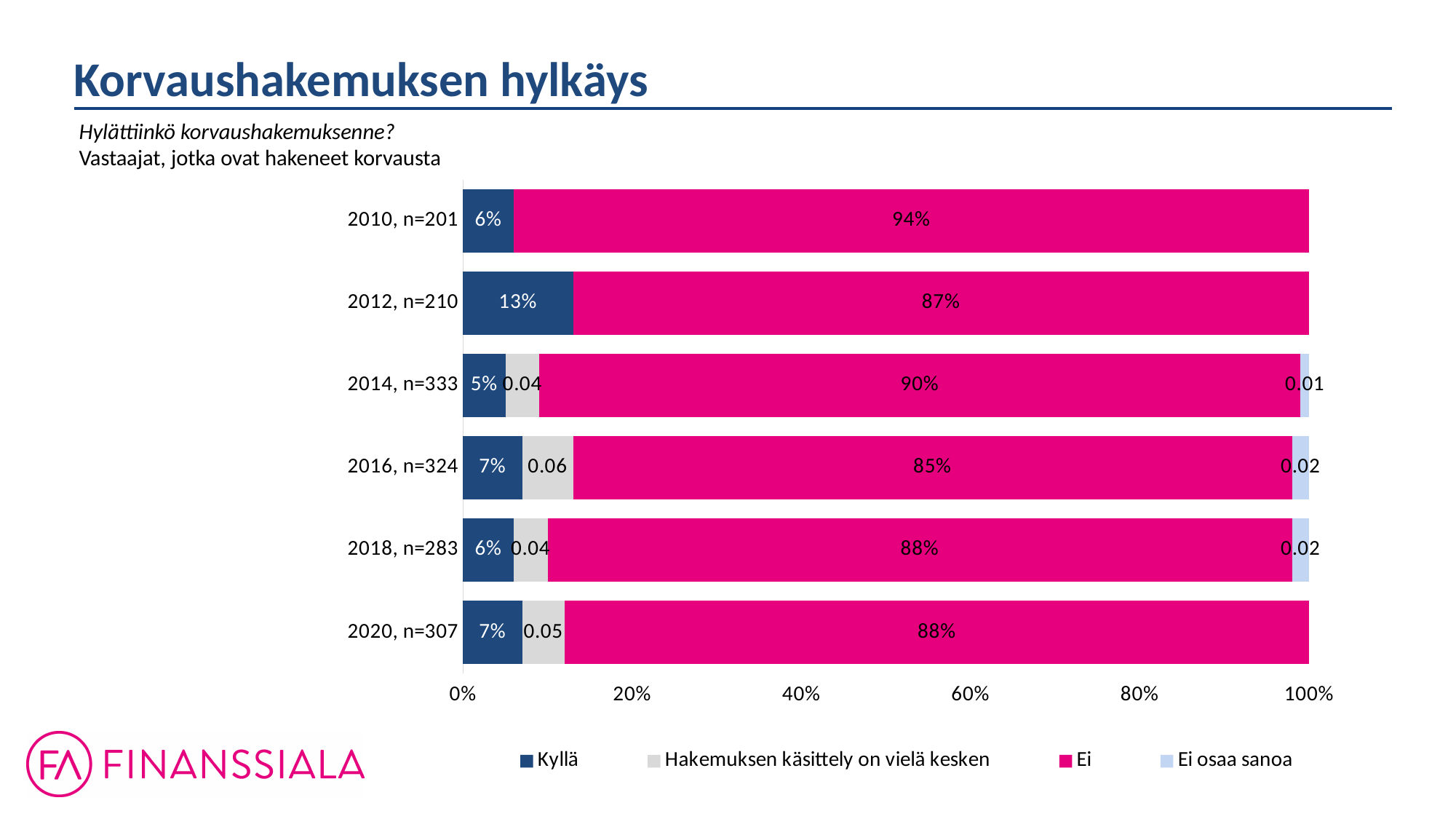
What is the value for Kyllä in 2012, n=210? 13% What kind of chart is shown on the slide? Stacked bar chart Which is larger: the Ei value in 2014, n=333 or in 2018, n=283? 2014, n=333 What is the value for Hakemuksen käsittely on vielä kesken in 2016, n=324? 0.06 What is the value for Ei in 2010, n=201? 94% How many series does the legend list? 4 What is the value for Ei osaa sanoa in 2014, n=333? 0.01 Which year has the lowest value for Ei? 2016, n=324 What is the title of the slide? Korvaushakemuksen hylkäys What is the difference between the Ei value in 2010, n=201 and in 2012, n=210? 7 percentage points Which year has the highest value for Kyllä? 2012, n=210 How many year categories are shown in the chart? 6